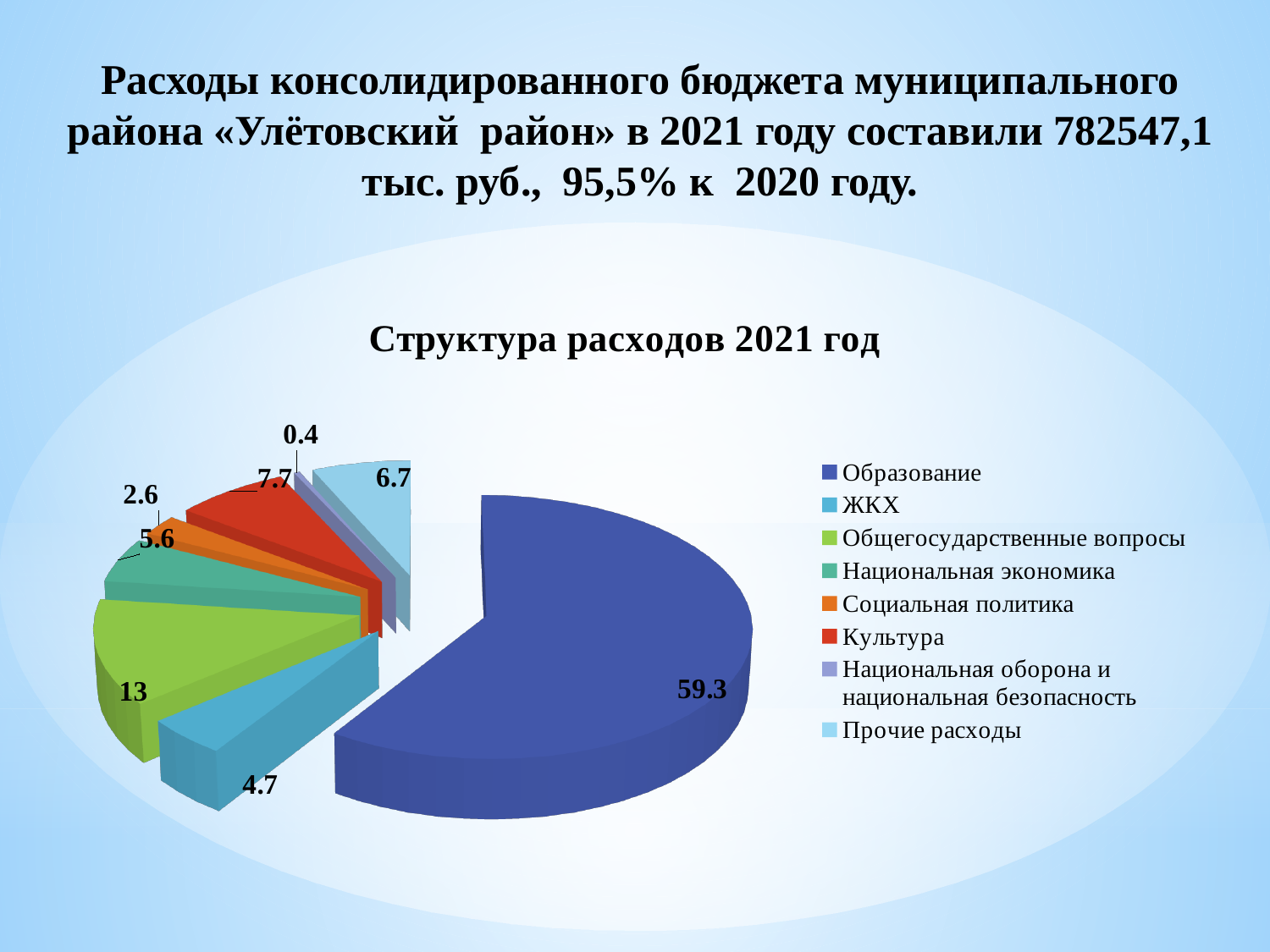
Which category has the smallest slice? Национальная оборона и национальная безопасность Which category has the largest slice? Образование What is the value for Образование? 59.3 Which category is shown in orange in the legend? Социальная политика What is the value for Общегосударственные вопросы? 13 What is the value for Национальная оборона и национальная безопасность? 0.4 What is the value for Культура? 7.7 What is the difference between the values for Общегосударственные вопросы and Прочие расходы? 6.3 What is the title of the chart? Структура расходов 2021 год What kind of chart is shown on the slide? pie chart Which is larger, the value for ЖКХ or the value for Национальная экономика? Национальная экономика How many categories does the pie chart have? 8